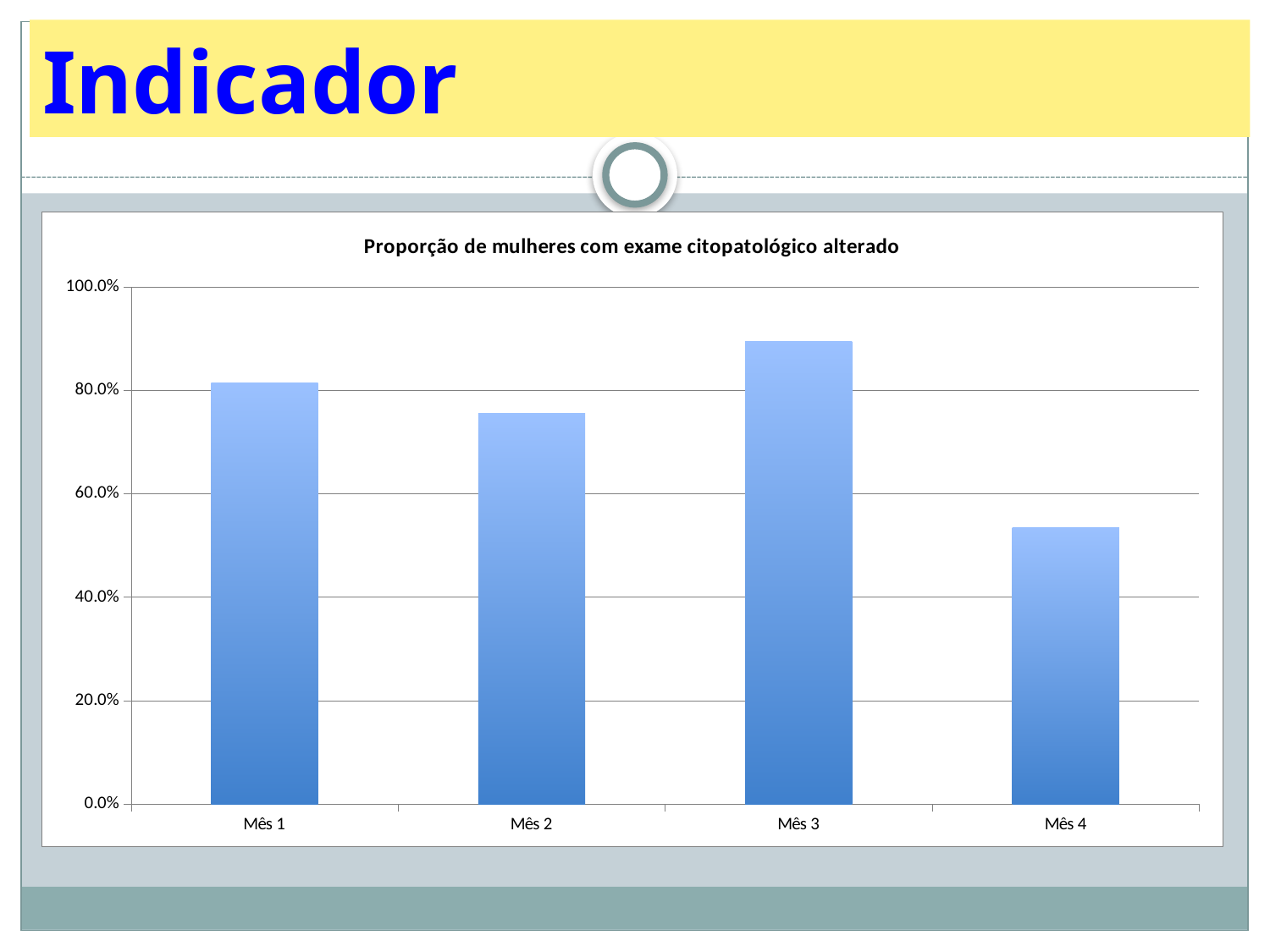
Which is larger, the value for Mês 2 or the value for Mês 4? Mês 2 Is the value for Mês 2 greater or less than 80.0%? less What kind of chart is shown on the slide? bar chart Is the value for Mês 1 greater or less than 80.0%? greater Does the value rise or fall from Mês 3 to Mês 4? fall What is the title of the chart? Proporção de mulheres com exame citopatológico alterado Which month has the highest proportion of women with altered cytopathological exam? Mês 3 Which is larger, the value for Mês 1 or the value for Mês 2? Mês 1 How many categories are plotted on the x axis? 4 Is the value for Mês 4 greater or less than 60.0%? less Which month has the lowest proportion of women with altered cytopathological exam? Mês 4